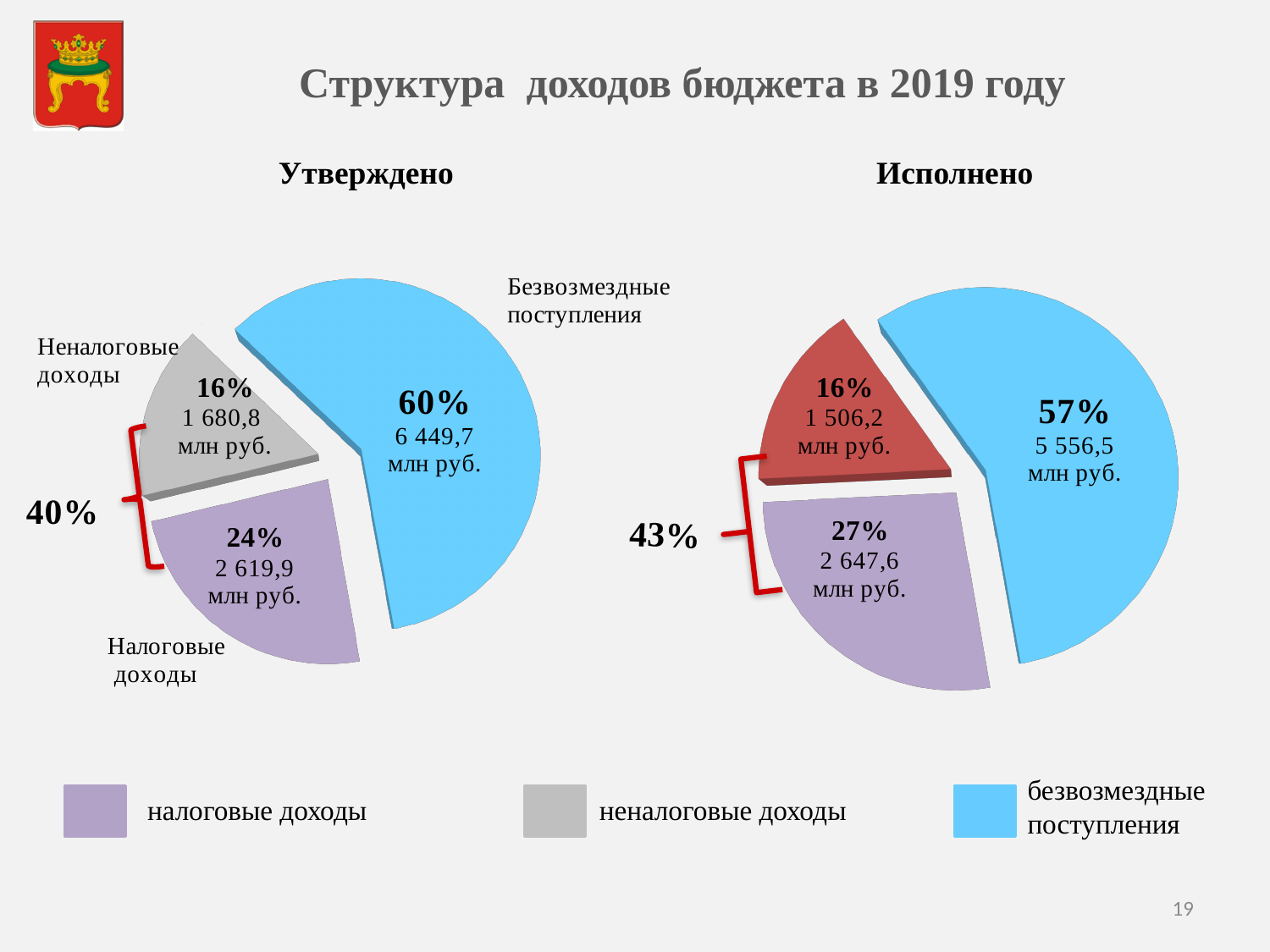
In the "Утверждено" chart, what is the value for неналоговые доходы in млн руб.? 1 680,8 млн руб. In the "Утверждено" chart, what is the value for налоговые доходы in млн руб.? 2 619,9 млн руб. In the "Утверждено" chart, which category has the smallest slice? Неналоговые доходы In the "Исполнено" chart, what is the value for налоговые доходы in млн руб.? 2 647,6 млн руб. In the "Исполнено" chart, what share do налоговые доходы have? 27% In the "Утверждено" chart, what share do безвозмездные поступления have? 60% What combined share is marked by the red bracket next to the "Исполнено" chart? 43% What is the difference in percentage points between the share of безвозмездные поступления in the "Утверждено" chart and in the "Исполнено" chart? 3 percentage points What kind of charts are shown on the slide? Pie charts How many slices does the "Утверждено" pie chart have? 3 In the "Исполнено" chart, what share do безвозмездные поступления have? 57% In the "Исполнено" chart, which category has the largest slice? Безвозмездные поступления